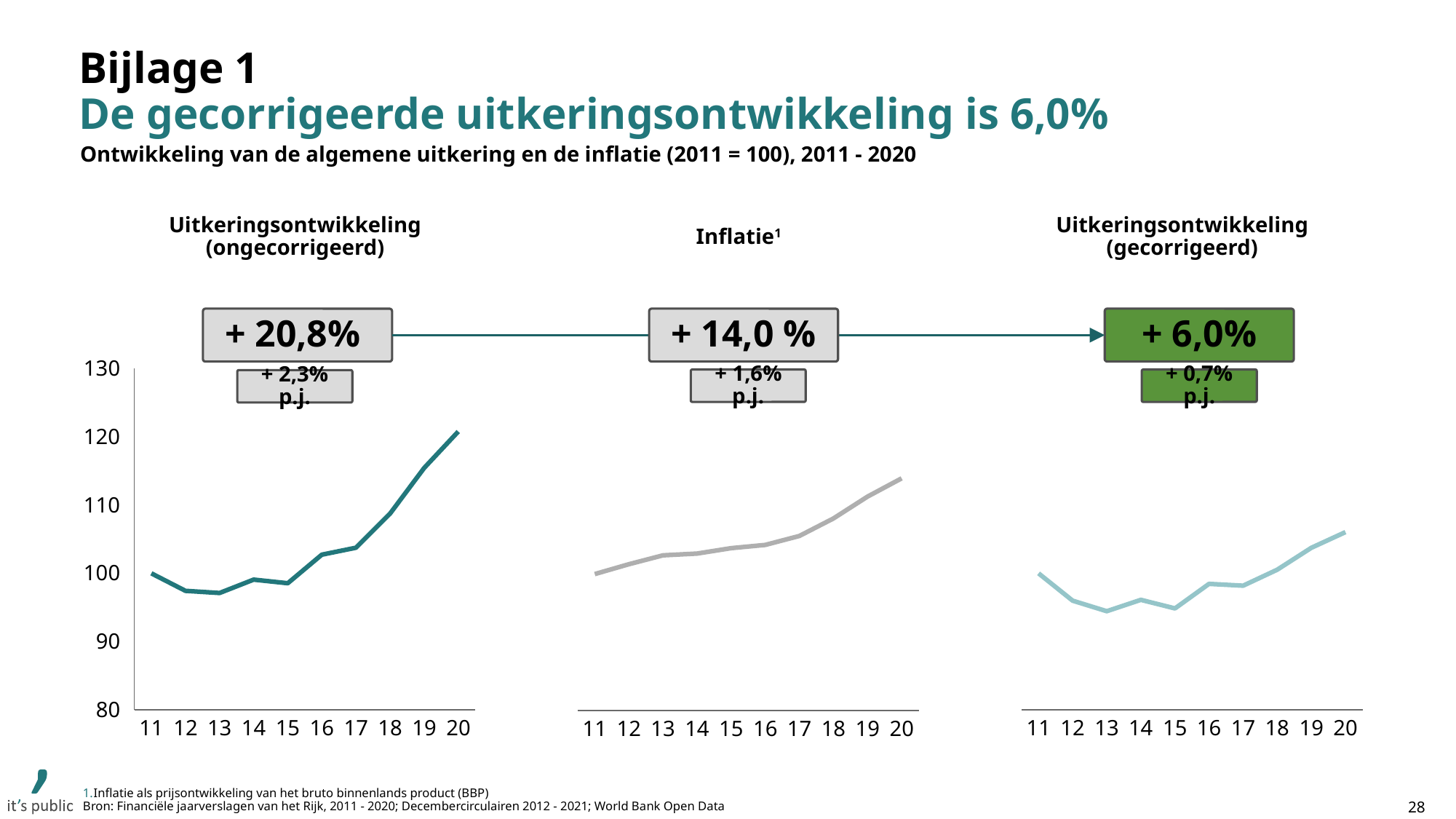
What annual growth rate (p.j.) is shown for the Inflatie chart? + 1,6% p.j. In the Uitkeringsontwikkeling (gecorrigeerd) chart, is the value for 13 greater or less than 100? less Does the line in the Inflatie chart rise or fall from 11 to 20? Rise What total growth is shown in the box above the Uitkeringsontwikkeling (ongecorrigeerd) chart? + 20,8% Which of the three charts has the highest value in year 20: Uitkeringsontwikkeling (ongecorrigeerd) or Uitkeringsontwikkeling (gecorrigeerd)? Uitkeringsontwikkeling (ongecorrigeerd) What total growth is shown in the green box above the Uitkeringsontwikkeling (gecorrigeerd) chart? + 6,0% What total growth is shown in the box above the Inflatie chart? + 14,0 % In the Inflatie chart, which year has the highest value? 20 What annual growth rate (p.j.) is shown for the Uitkeringsontwikkeling (gecorrigeerd) chart? + 0,7% p.j. How many years are plotted on the x axis of the Inflatie chart? 10 In the Uitkeringsontwikkeling (ongecorrigeerd) chart, is the value for 20 greater or less than 110? greater What kind of chart is used for the Uitkeringsontwikkeling (ongecorrigeerd) panel? Line chart